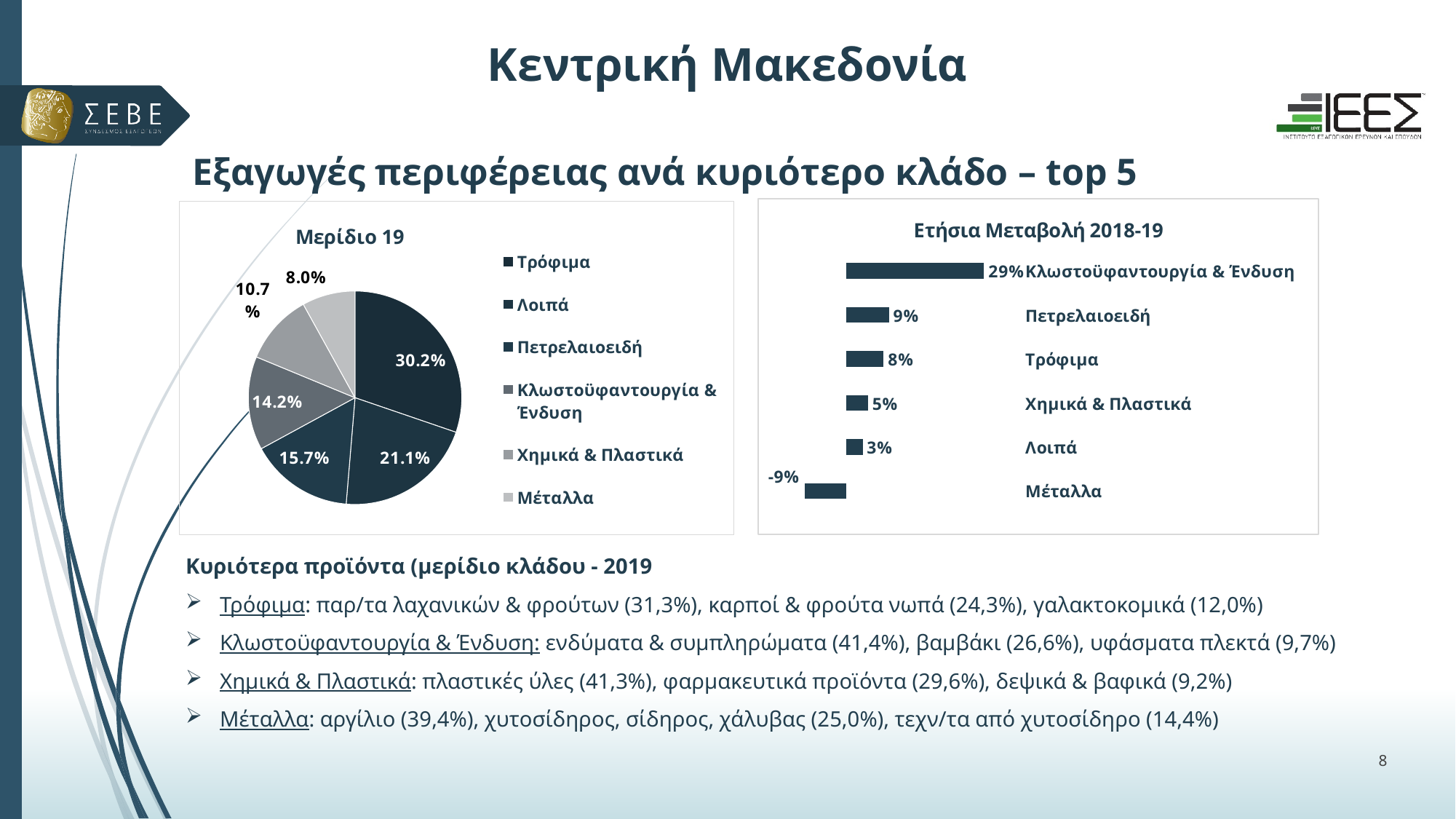
In the pie chart 'Μερίδιο 19', how many categories does the legend list? 6 What type of chart is 'Ετήσια Μεταβολή 2018-19'? bar chart In the pie chart 'Μερίδιο 19', which category has the smallest share? Μέταλλα What type of chart is 'Μερίδιο 19'? pie chart In the pie chart 'Μερίδιο 19', which category has the largest share? Τρόφιμα In the chart 'Ετήσια Μεταβολή 2018-19', what is the value for Μέταλλα? -9% In the chart 'Ετήσια Μεταβολή 2018-19', what is the value for Κλωστοϋφαντουργία & Ένδυση? 29% In the chart 'Ετήσια Μεταβολή 2018-19', what is the difference between the values for Πετρελαιοειδή and Τρόφιμα? 1% In the chart 'Ετήσια Μεταβολή 2018-19', which category has the lowest value? Μέταλλα In the pie chart 'Μερίδιο 19', what is the share for Μέταλλα? 8.0% In the chart 'Ετήσια Μεταβολή 2018-19', which is larger, the value for Χημικά & Πλαστικά or the value for Λοιπά? Χημικά & Πλαστικά In the pie chart 'Μερίδιο 19', what is the share for Τρόφιμα? 30.2%